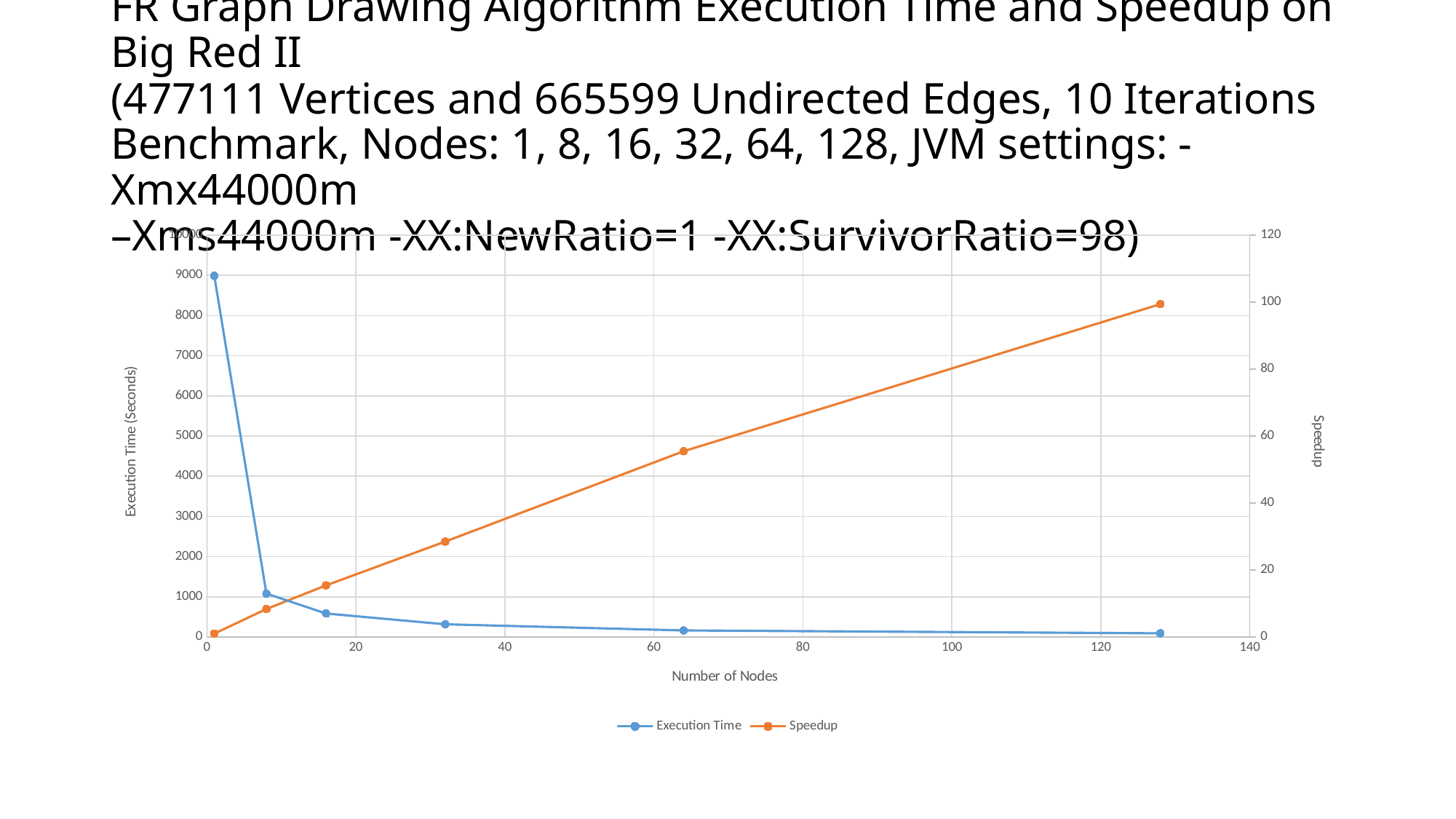
How many series does the legend list? 2 Does the Execution Time series rise or fall as the number of nodes increases? Falls Is the Execution Time at 16 nodes greater or less than 1000 seconds? less At which number of nodes is the Execution Time highest? 1 What kind of chart is shown on the slide? Line chart At which number of nodes is the Speedup highest? 128 Does the Speedup series rise or fall as the number of nodes increases? Rises How many data points are plotted for the Execution Time series? 6 Which is larger, the Speedup at 32 nodes or the Speedup at 64 nodes? 64 nodes Is the Speedup at 64 nodes greater or less than 40? greater What is the title of the x axis? Number of Nodes Is the Execution Time at 1 node greater or less than 8000 seconds? greater